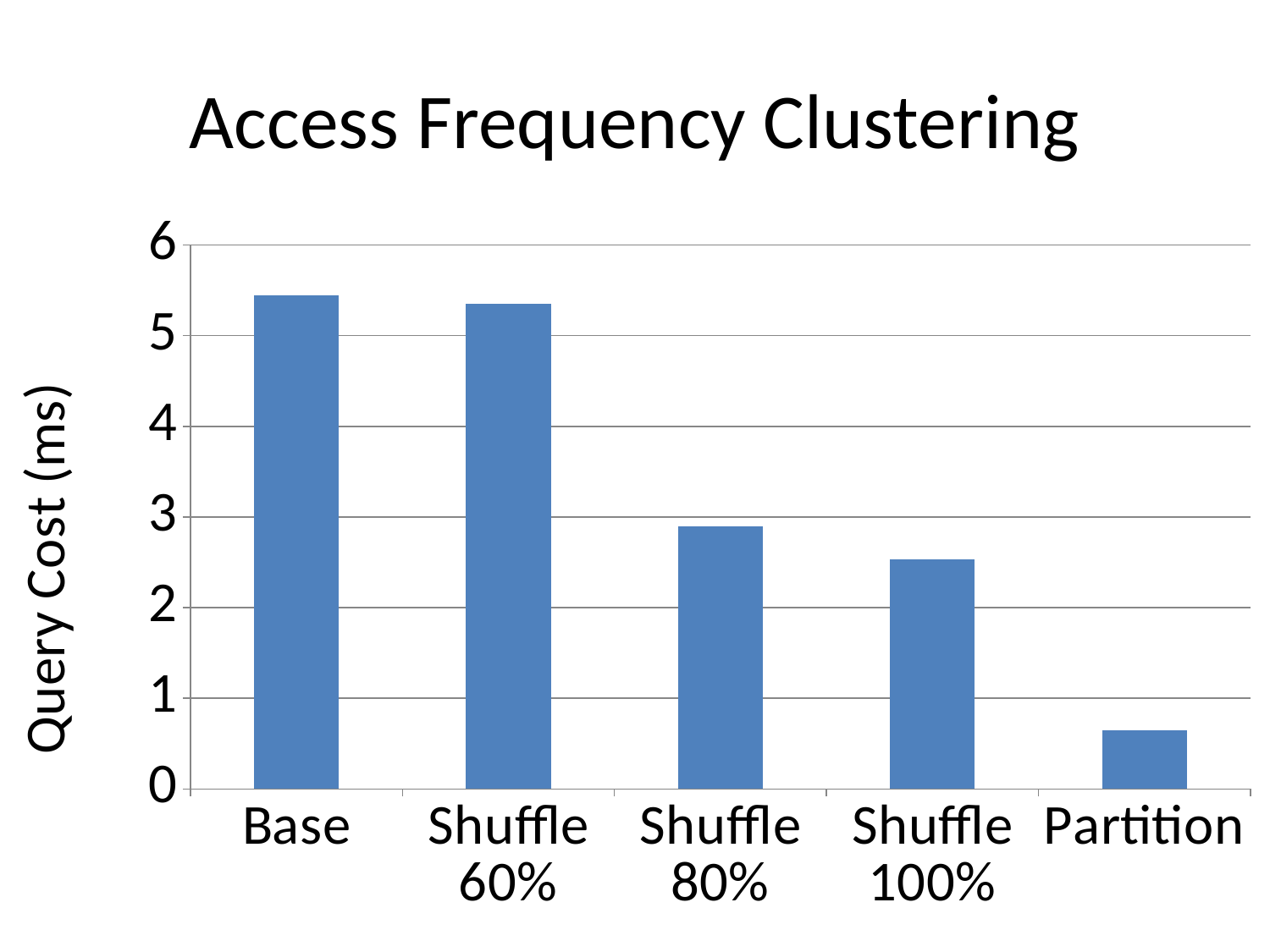
Which category has the lowest query cost? Partition Is the value for Shuffle 60% greater or less than 5? greater What type of chart is shown on the slide? bar chart How many categories are shown on the x axis? 5 Which has a higher query cost, Shuffle 80% or Shuffle 100%? Shuffle 80% What is the title of the chart? Access Frequency Clustering Is the value for Base greater or less than 5? greater Is the value for Partition greater or less than 1? less Do the query cost values rise or fall moving from Base to Partition along the x axis? fall What is the label of the vertical axis? Query Cost (ms)